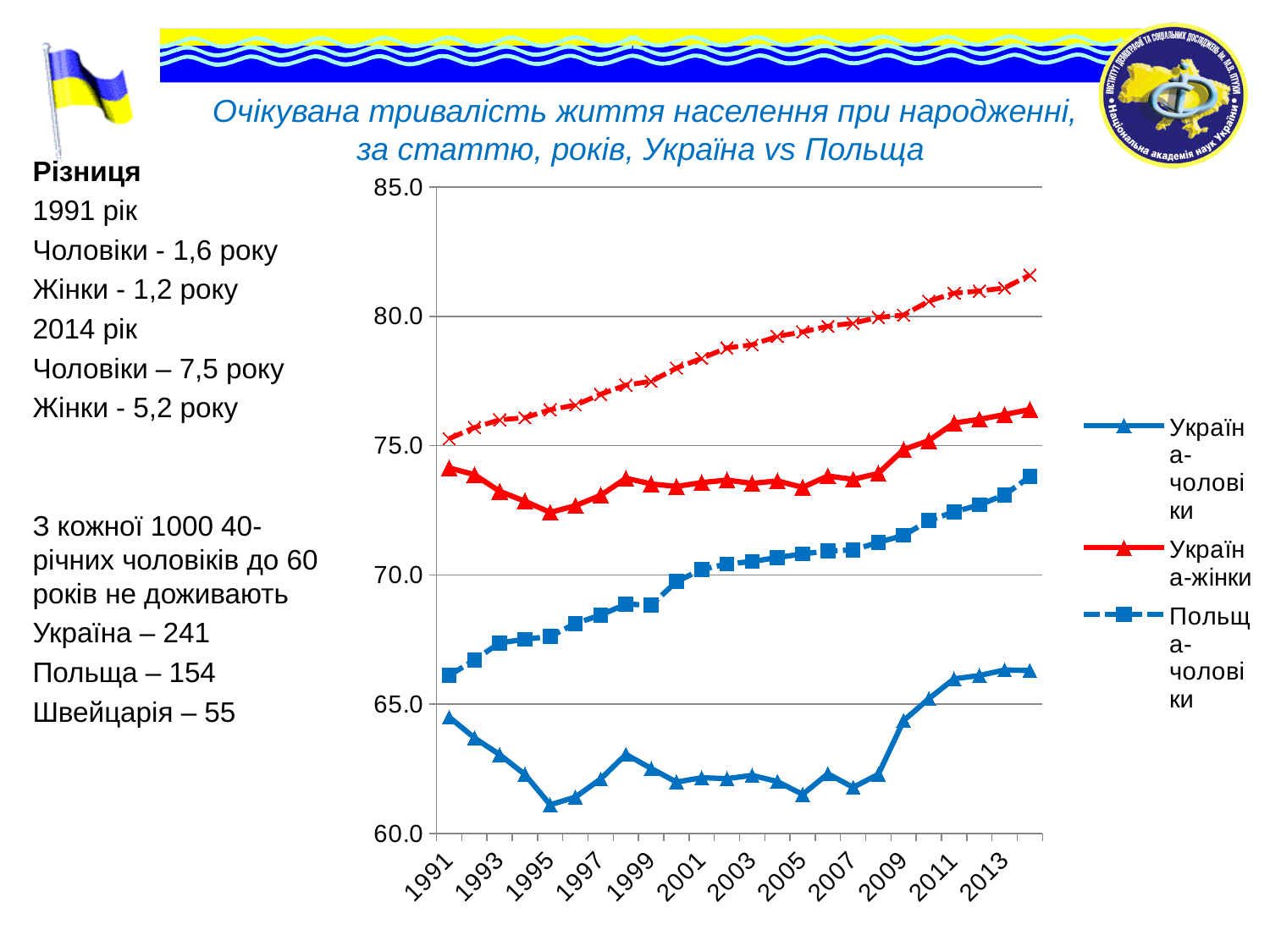
Is the value for Україна-жінки in 1991 greater or less than 75? less Do the values for Польща-чоловіки generally rise or fall from 1991 to 2013? rise In 2013, which is higher: Україна-чоловіки or Польща-чоловіки? Польща-чоловіки Which series has the lowest values throughout the chart? Україна-чоловіки What kind of chart is shown on the slide? line chart What is the highest value shown on the vertical axis of the chart? 85.0 Is the value for Польща-чоловіки in 2013 greater or less than 70? greater Is the value for Польща-чоловіки in 1991 greater or less than 70? less How many series does the chart legend list? 3 In 1991, which is higher: Україна-жінки or Польща-чоловіки? Україна-жінки